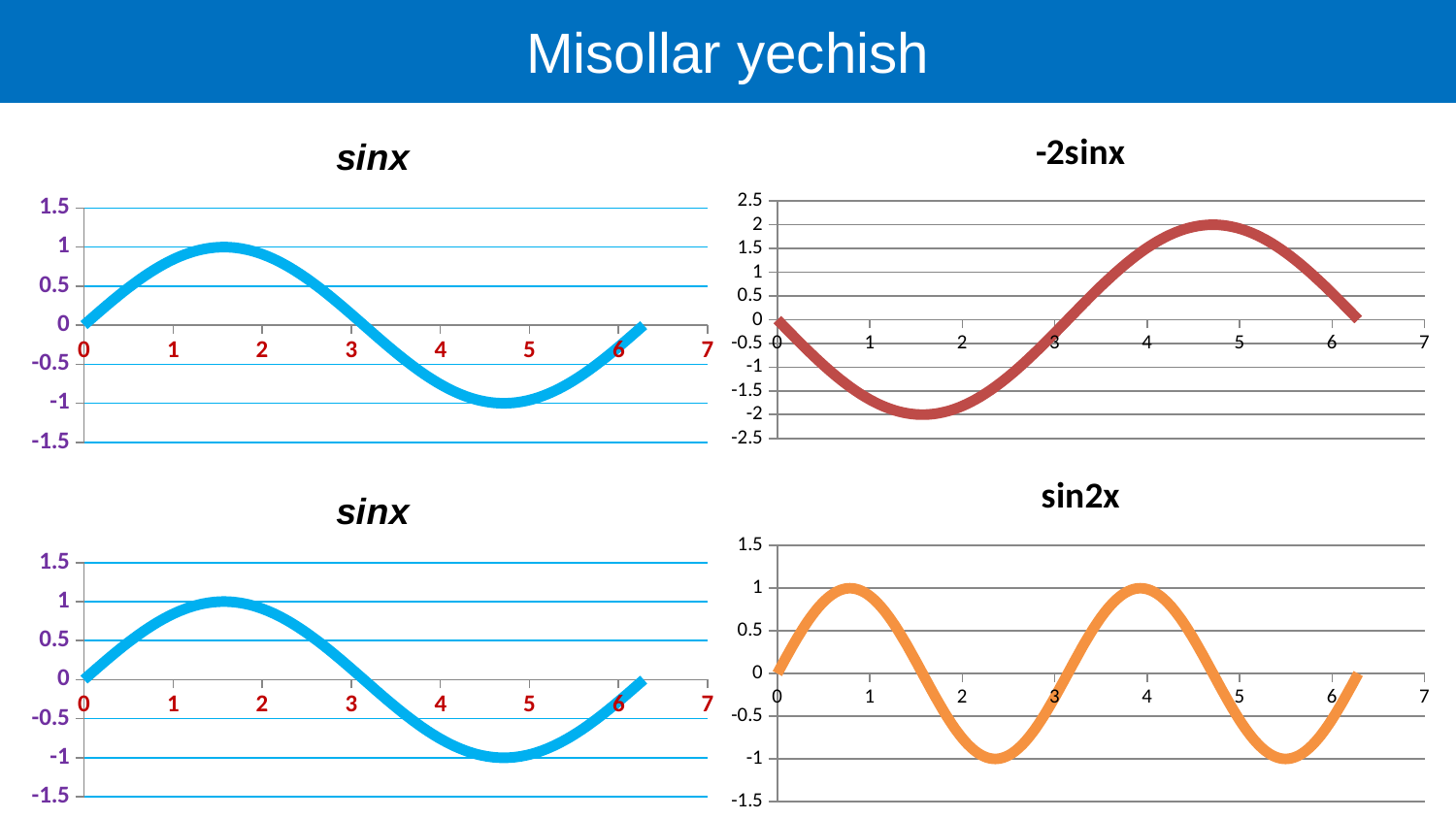
In the top-left chart titled sinx, is the value at x = 1 greater or less than 0.5? greater In the top-right chart titled -2sinx, what is the highest value the curve reaches? 2 In the bottom-right chart titled sin2x, what is the highest value the curve reaches? 1 In the top-right chart titled -2sinx, what is the lowest value the curve reaches? -2 In the bottom-right chart titled sin2x, is the value at x = 2 greater or less than -0.5? less In the top-right chart titled -2sinx, does the curve rise or fall between x = 2 and x = 4? rise How many charts are shown on the slide? 4 In the top-right chart titled -2sinx, is the value at x = 1 greater or less than -1? less What colour is the line in the bottom-right chart titled sin2x? orange In the top-left chart titled sinx, what is the lowest value the curve reaches? -1 What kind of chart is the top-left chart titled sinx? line chart